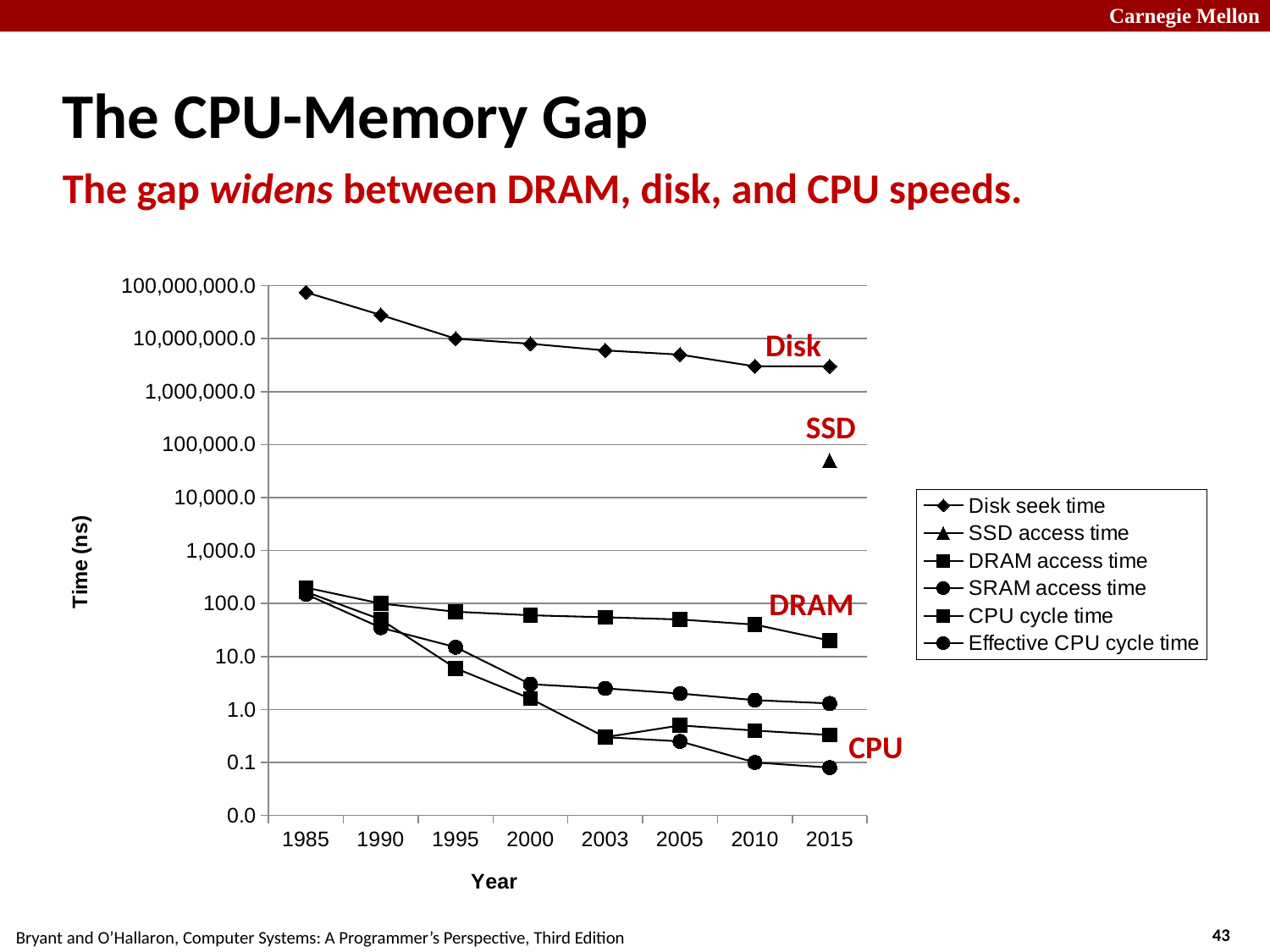
Does the Disk seek time rise or fall from 1985 to 2015? fall Is the SSD access time in 2015 greater or less than 100,000.0? less Is the Disk seek time in 1985 greater or less than 10,000,000.0? greater How many series does the legend list? 6 Does the DRAM access time rise or fall from 1985 to 2015? fall Is the DRAM access time in 2015 greater or less than 100.0? less What kind of chart is shown on the slide? line chart Which series has the lowest value in 2015? Effective CPU cycle time Which series has the highest values across all years? Disk seek time How many years are marked along the x axis? 8 What is the label of the y axis? Time (ns)